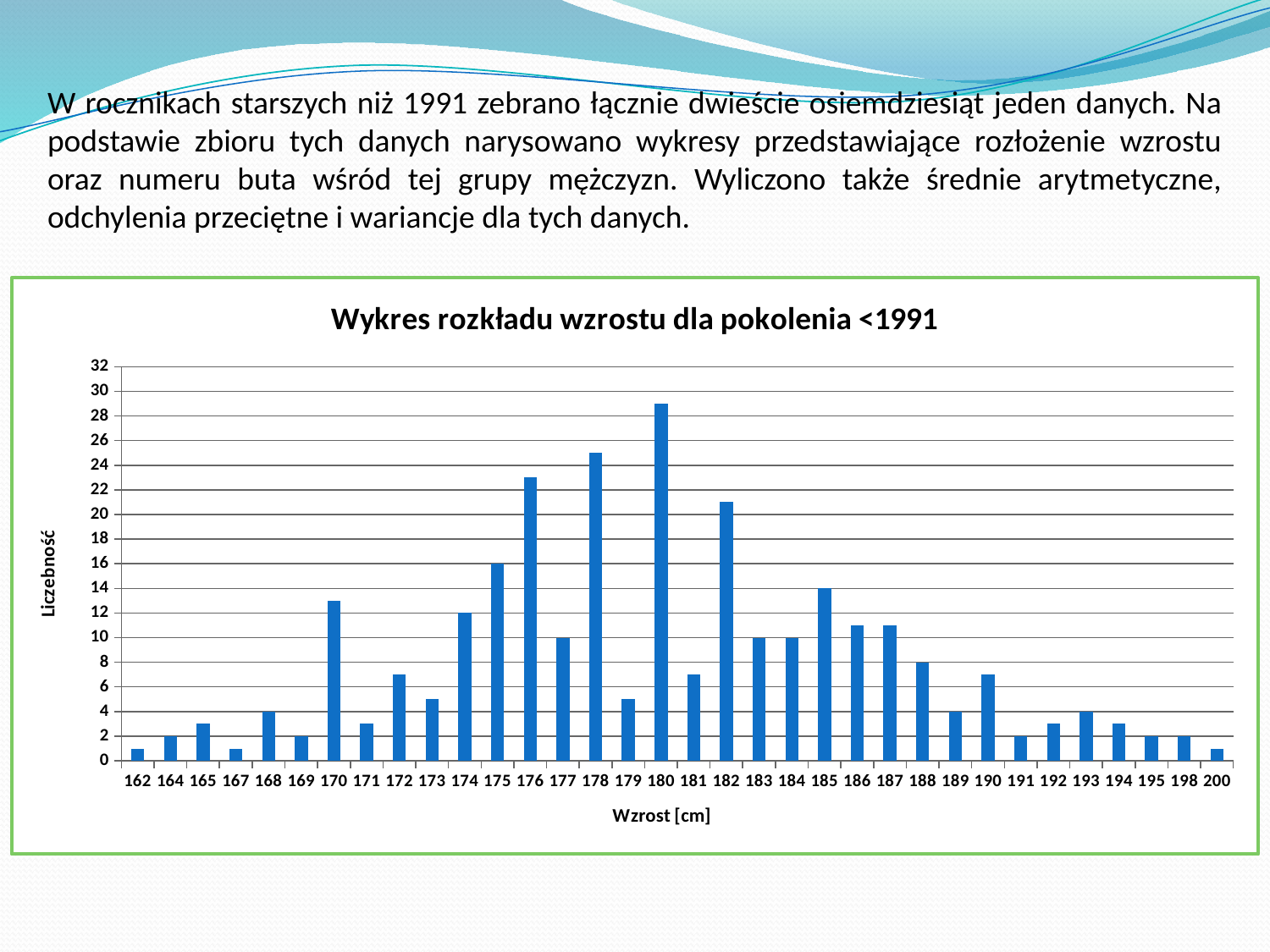
How many height categories are shown on the x axis? 34 What is the Liczebność for height 175? 16 Which has a higher Liczebność, height 178 or height 182? 178 What is the Liczebność for height 174? 12 What is the label of the vertical axis? Liczebność Is the Liczebność for height 180 greater or less than 28? greater What kind of chart is shown on the slide? bar chart Is the Liczebność for height 170 greater or less than 12? greater What is the Liczebność for height 185? 14 Which height (Wzrost) has the highest Liczebność? 180 What is the title of the chart? Wykres rozkładu wzrostu dla pokolenia <1991 What is the difference in Liczebność between height 175 and height 174? 4